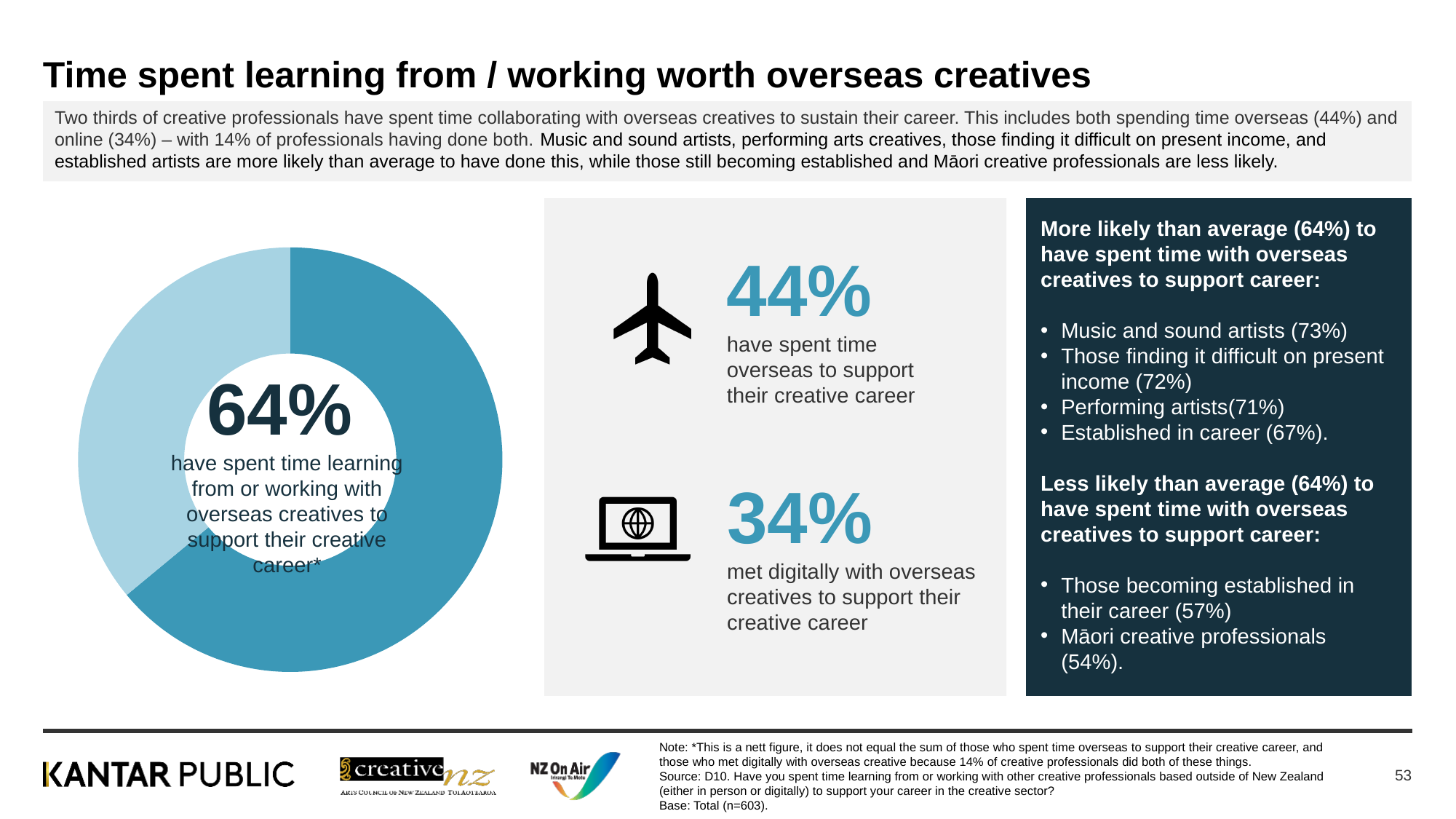
Is the value shown in the donut chart greater or less than 50%? greater What does the 64% in the donut chart represent? Have spent time learning from or working with overseas creatives to support their creative career What percentage met digitally with overseas creatives to support their creative career, according to the figure next to the laptop icon? 34% What is the difference between the percentage who spent time overseas (44%) and the percentage who met digitally (34%)? 10 percentage points Which segment of the donut chart is larger, the dark blue one or the light blue one? Dark blue How many segments does the donut chart have? 2 What percentage of creative professionals have spent time overseas to support their creative career, according to the figure next to the plane icon? 44% What percentage is shown in the centre of the donut chart? 64% Which is larger: the percentage who spent time overseas or the percentage who met digitally with overseas creatives? Spent time overseas (44%) What kind of chart is shown on the left of the slide? Pie (donut) chart What share of the donut chart does the dark blue segment represent? 64%